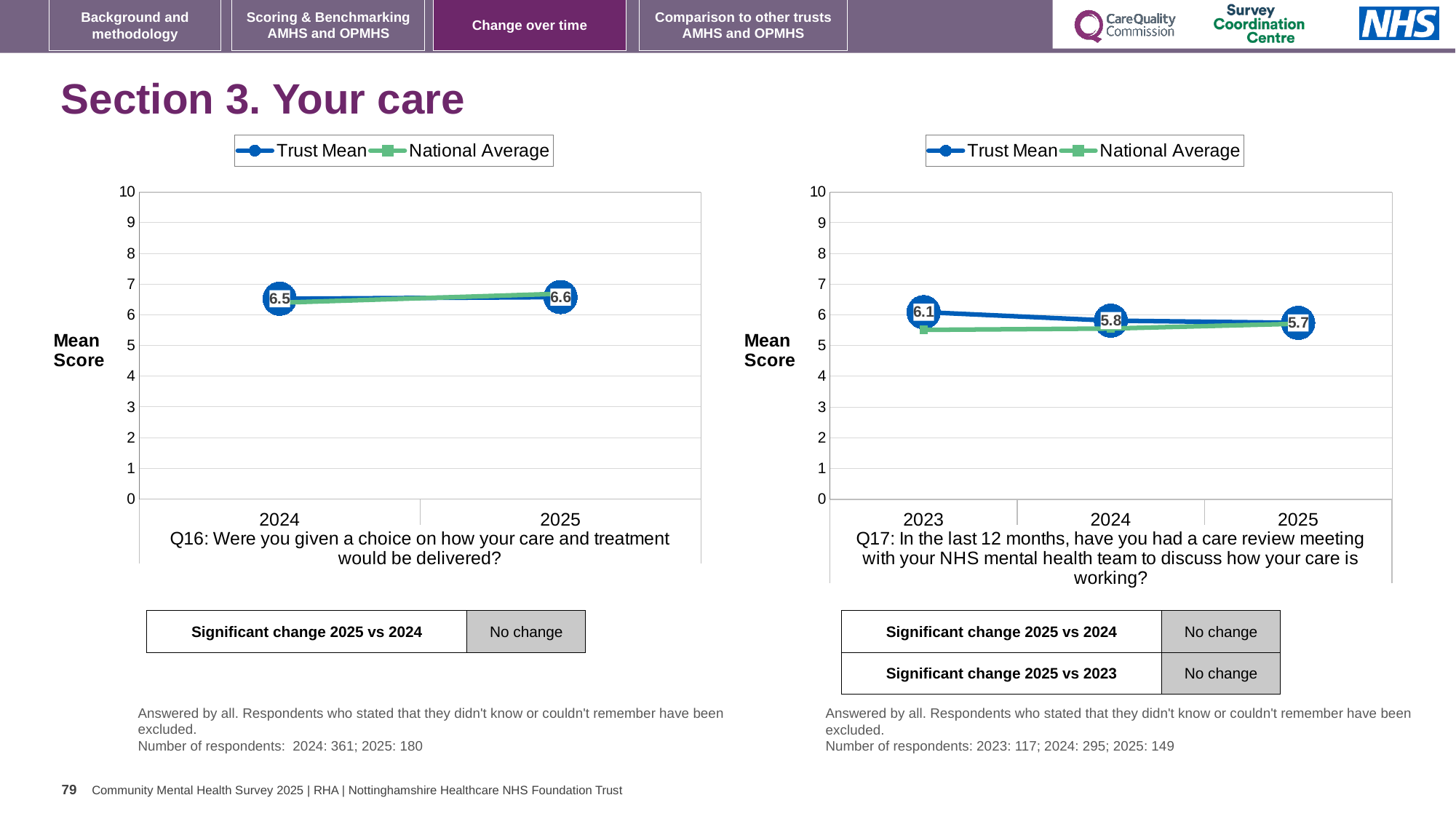
In the left chart (Q16), what is the Trust Mean for 2025? 6.6 In the left chart (Q16), what is the difference between the Trust Mean for 2025 and the Trust Mean for 2024? 0.1 In the right chart (Q17), what is the Trust Mean for 2023? 6.1 How many years are plotted on the x axis of the right chart (Q17)? 3 In the right chart (Q17), which year has the highest Trust Mean? 2023 In the right chart (Q17), what is the difference between the Trust Mean for 2023 and the Trust Mean for 2025? 0.4 In the left chart (Q16), what is the Trust Mean for 2024? 6.5 What kind of chart is the left chart (Q16)? line chart In the right chart (Q17), does the Trust Mean rise or fall from 2023 to 2025? fall In the right chart (Q17), which year has the lowest Trust Mean? 2025 How many series does the legend of the left chart (Q16) list? 2 In the right chart (Q17), what is the Trust Mean for 2025? 5.7